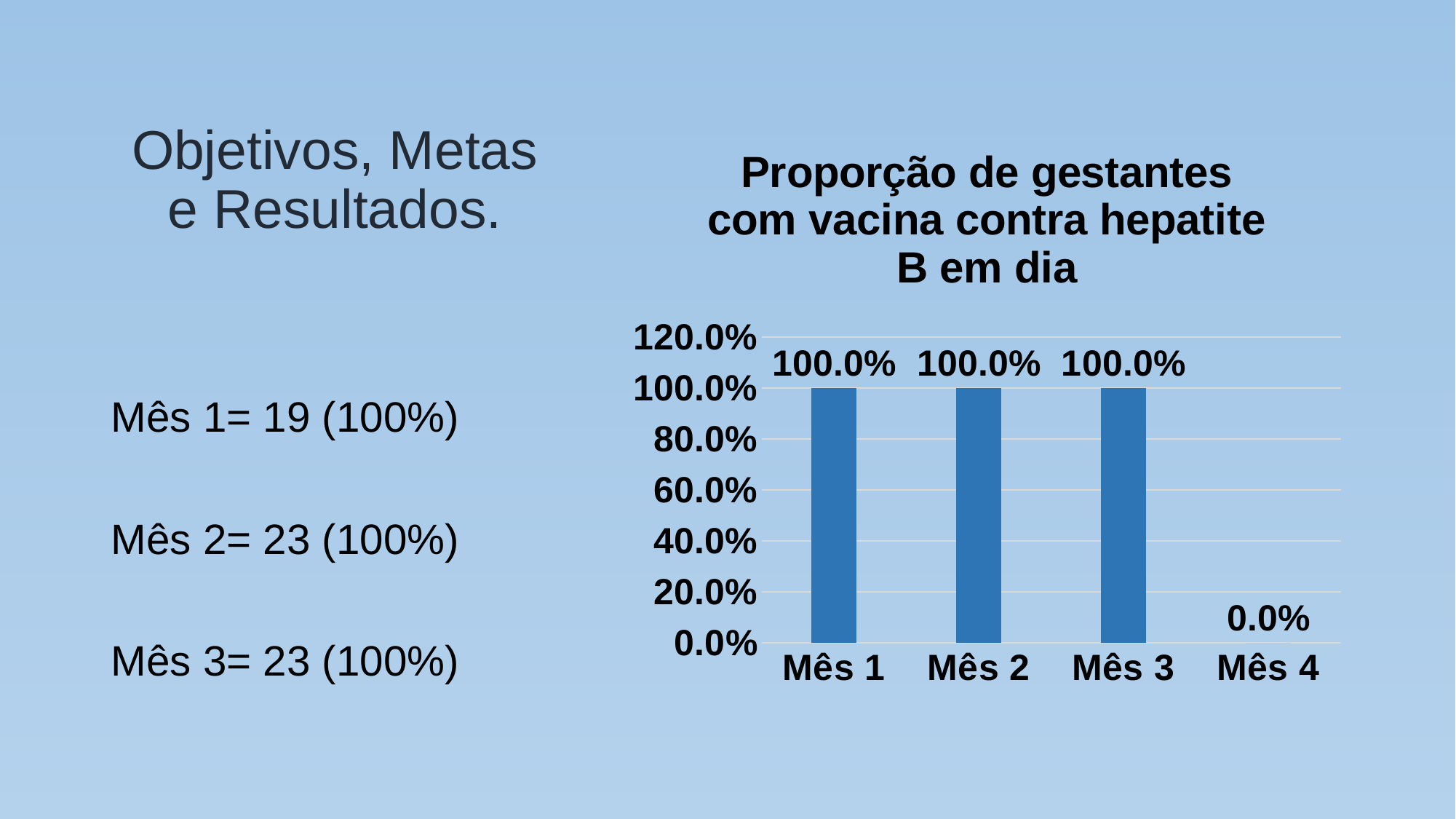
What is the title of the chart? Proporção de gestantes com vacina contra hepatite B em dia What is the value for Mês 1? 100.0% Do the values rise or fall from Mês 3 to Mês 4? fall Which category has the lowest value? Mês 4 Is the value for Mês 2 greater or less than 80.0%? greater What is the highest tick value shown on the y axis? 120.0% What is the value for Mês 4? 0.0% What is the value for Mês 3? 100.0% What is the difference between the values for Mês 2 and Mês 4? 100.0% What kind of chart is shown? bar chart Which is larger, the value for Mês 3 or the value for Mês 4? Mês 3 How many categories are shown on the x axis? 4